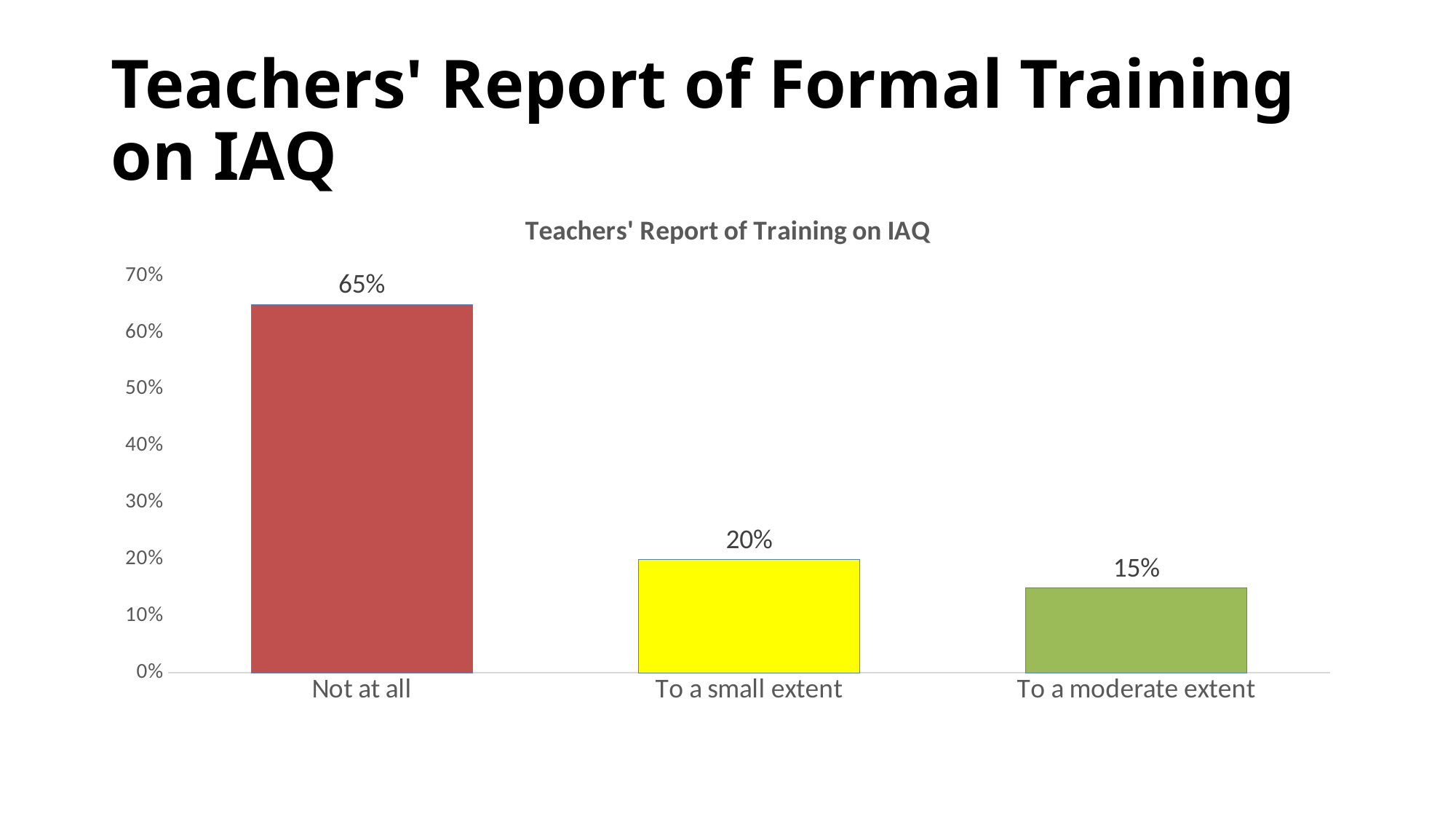
Which category has the highest value? Not at all How many categories are shown on the x axis? 3 What is the difference between the values for 'To a small extent' and 'To a moderate extent'? 5% What percentage of teachers reported 'Not at all' for formal training on IAQ? 65% What is the value for 'To a moderate extent'? 15% What is the value for 'To a small extent'? 20% What is the difference between the values for 'Not at all' and 'To a small extent'? 45% What is the title of the chart? Teachers' Report of Training on IAQ Which category has the lowest value? To a moderate extent What kind of chart is shown on the slide? Bar chart Which is larger, the value for 'To a small extent' or 'To a moderate extent'? To a small extent Is the value for 'Not at all' greater or less than 60%? greater